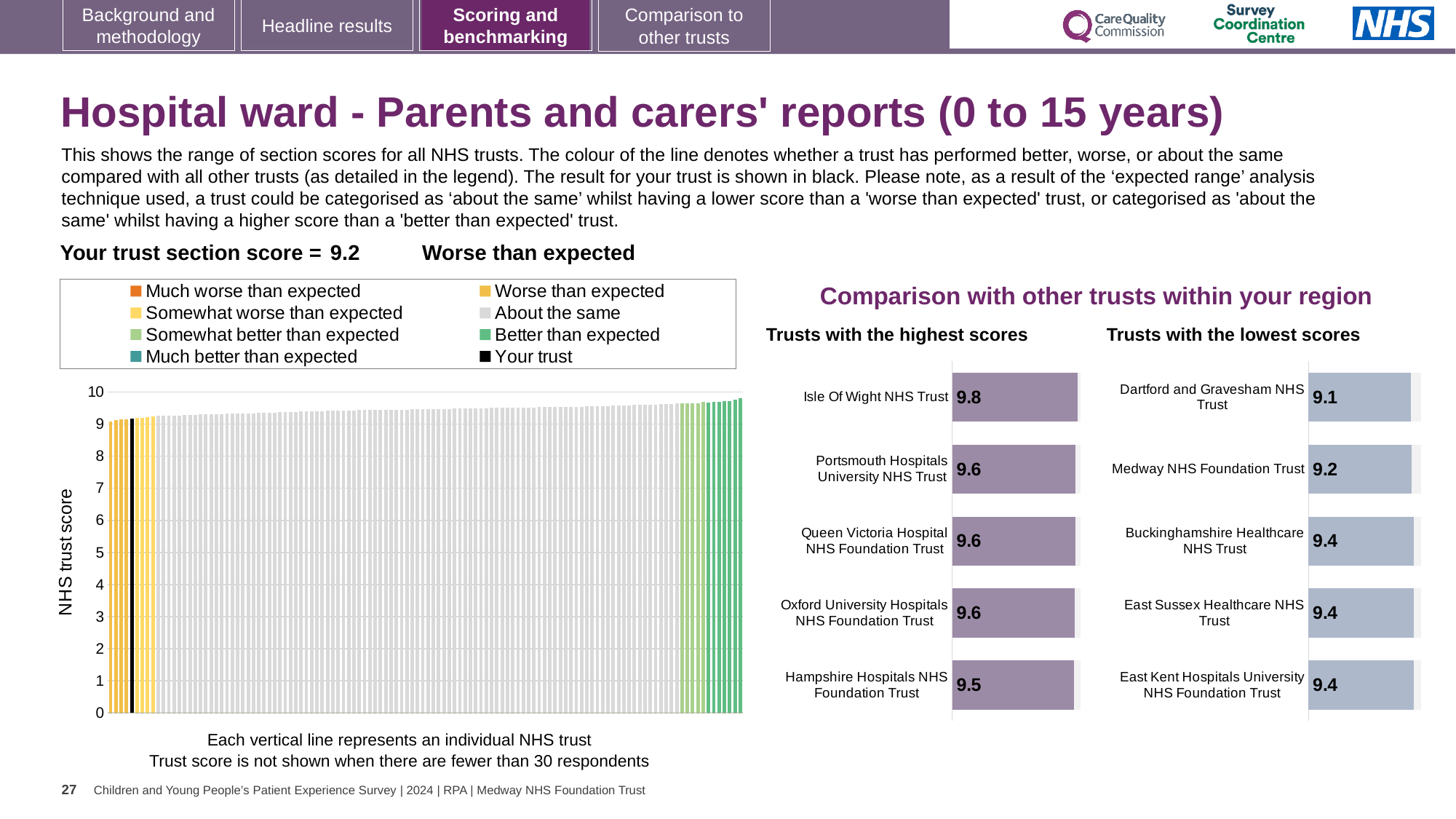
What kind of chart is the large chart on the left showing NHS trust scores? Bar chart How many trusts are shown in the 'Trusts with the lowest scores' chart? 5 In the 'Trusts with the highest scores' chart, what is the score for Hampshire Hospitals NHS Foundation Trust? 9.5 In the 'Trusts with the highest scores' chart, which has the larger score: Isle Of Wight NHS Trust or Portsmouth Hospitals University NHS Trust? Isle Of Wight NHS Trust In the large chart on the left, do the NHS trust scores rise or fall from left to right? Rise In the 'Trusts with the lowest scores' chart, what is the difference between the scores of Medway NHS Foundation Trust and Dartford and Gravesham NHS Trust? 0.1 In the 'Trusts with the highest scores' chart, which trust has the highest score? Isle Of Wight NHS Trust In the 'Trusts with the lowest scores' chart, what is the score for Dartford and Gravesham NHS Trust? 9.1 In the 'Trusts with the lowest scores' chart, which trust has the lowest score? Dartford and Gravesham NHS Trust In the 'Trusts with the highest scores' chart, what is the difference between the scores of Isle Of Wight NHS Trust and Hampshire Hospitals NHS Foundation Trust? 0.3 In the 'Trusts with the highest scores' chart, what is the score for Isle Of Wight NHS Trust? 9.8 In the 'Trusts with the lowest scores' chart, what is the score for Medway NHS Foundation Trust? 9.2